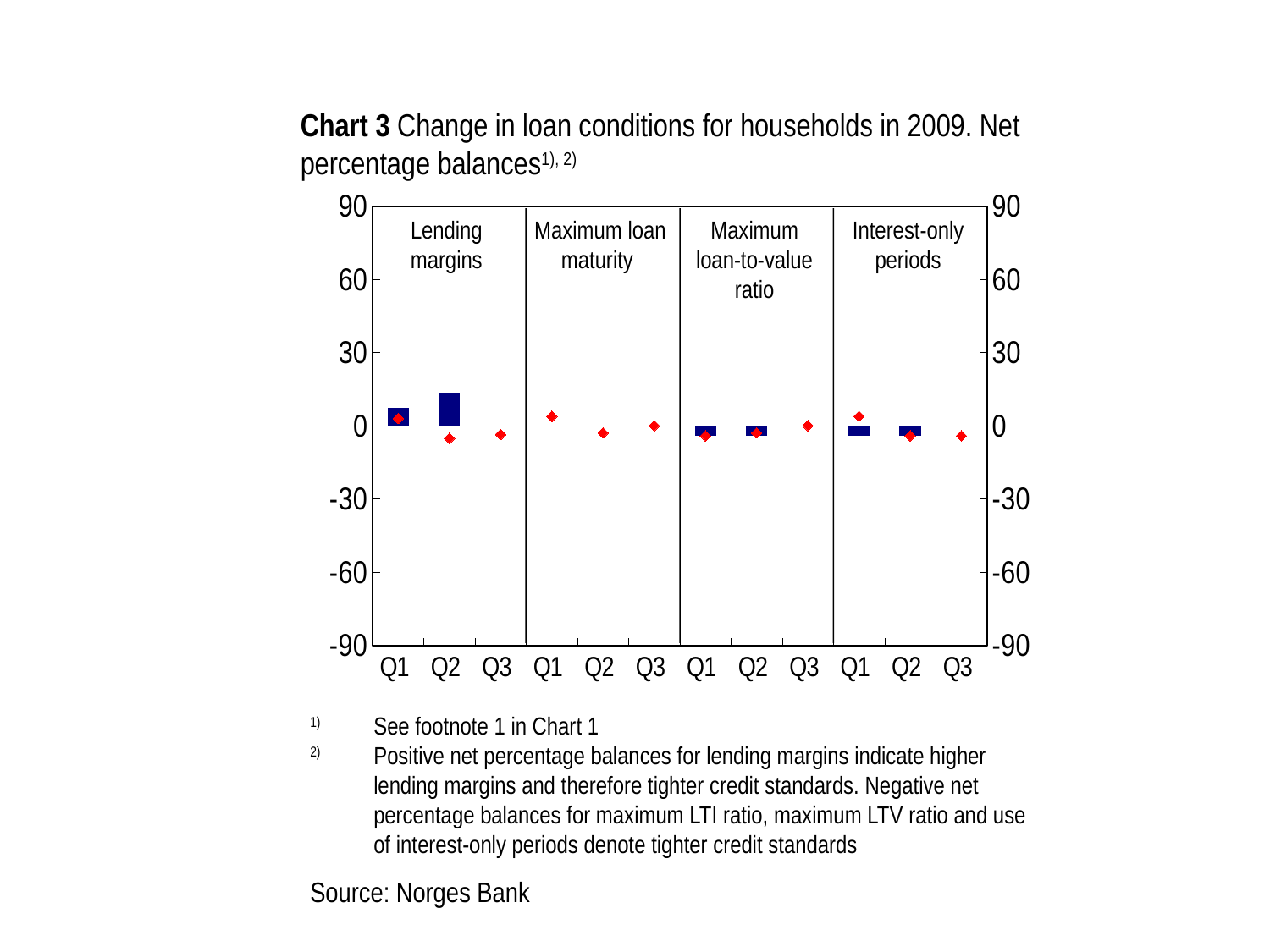
Is the Interest-only periods bar for Q2 greater or less than -30? greater How many quarters are shown in each panel of the chart? 3 Is the Lending margins bar for Q2 greater or less than 30? less Which panel and quarter has the highest bar in the chart? Lending margins, Q2 How many loan-condition panels does the chart have? 4 What is the title of the chart? Chart 3 Change in loan conditions for households in 2009. Net percentage balances What kind of chart is shown on the slide? bar chart with diamond markers (combination bar and line chart) What is the highest value shown on the chart's vertical axis? 90 Is the Lending margins bar for Q1 greater or less than 0? greater In the Lending margins panel, which bar is larger, Q1 or Q2? Q2